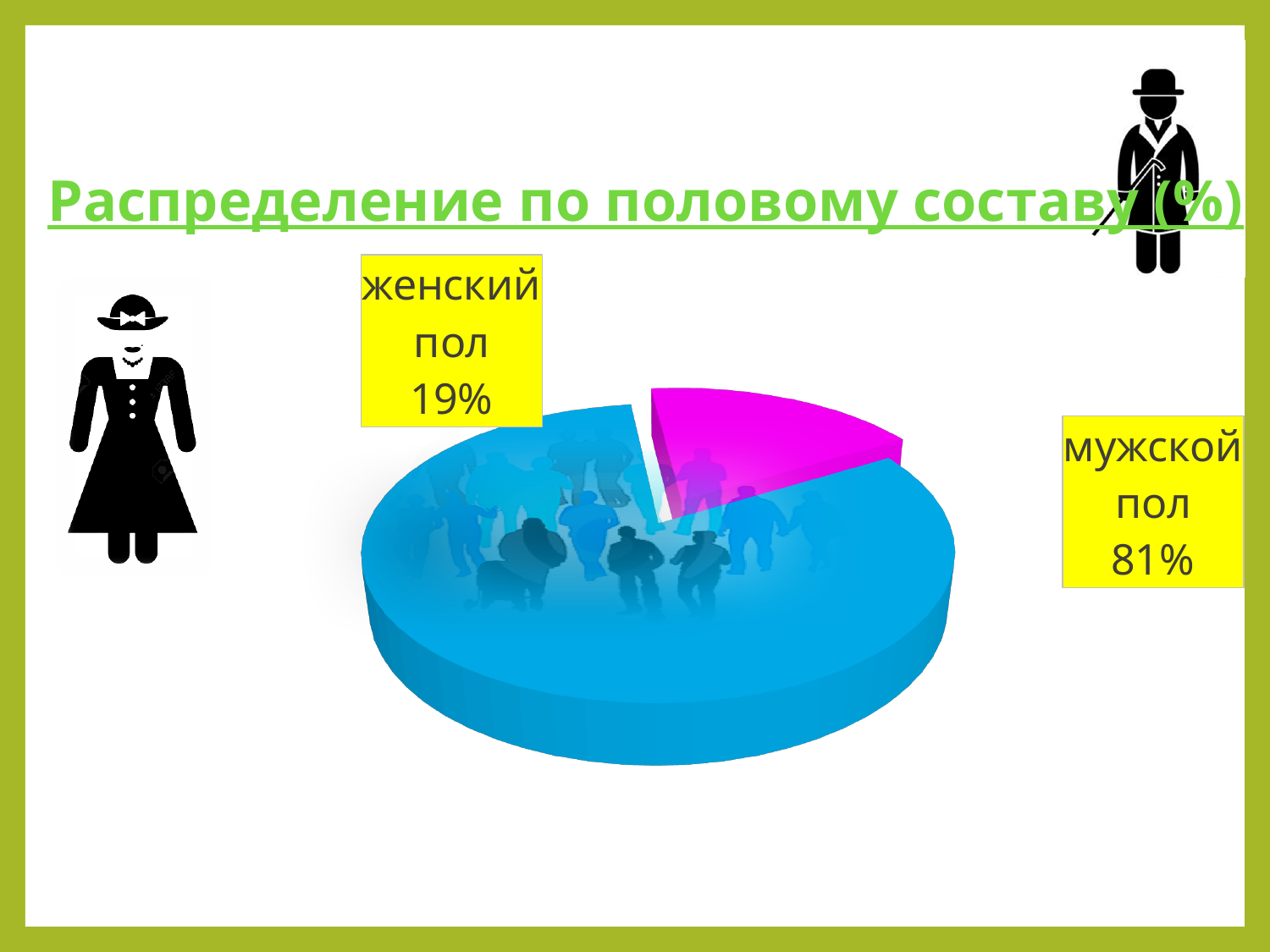
Which is larger: the share for "женский пол" or the share for "мужской пол"? мужской пол What colour is the slice for "мужской пол"? blue What kind of chart is shown on the slide? pie chart How many slices does the pie chart have? 2 What percentage does the slice labelled "женский пол" represent? 19% What share of the pie does the "женский пол" slice take? 19% Which category has the smallest share of the pie? женский пол What is the difference in percentage points between the "мужской пол" and "женский пол" slices? 62 Which category has the largest share of the pie? мужской пол What percentage does the slice labelled "мужской пол" represent? 81% What is the title of the chart on the slide? Распределение по половому составу (%)